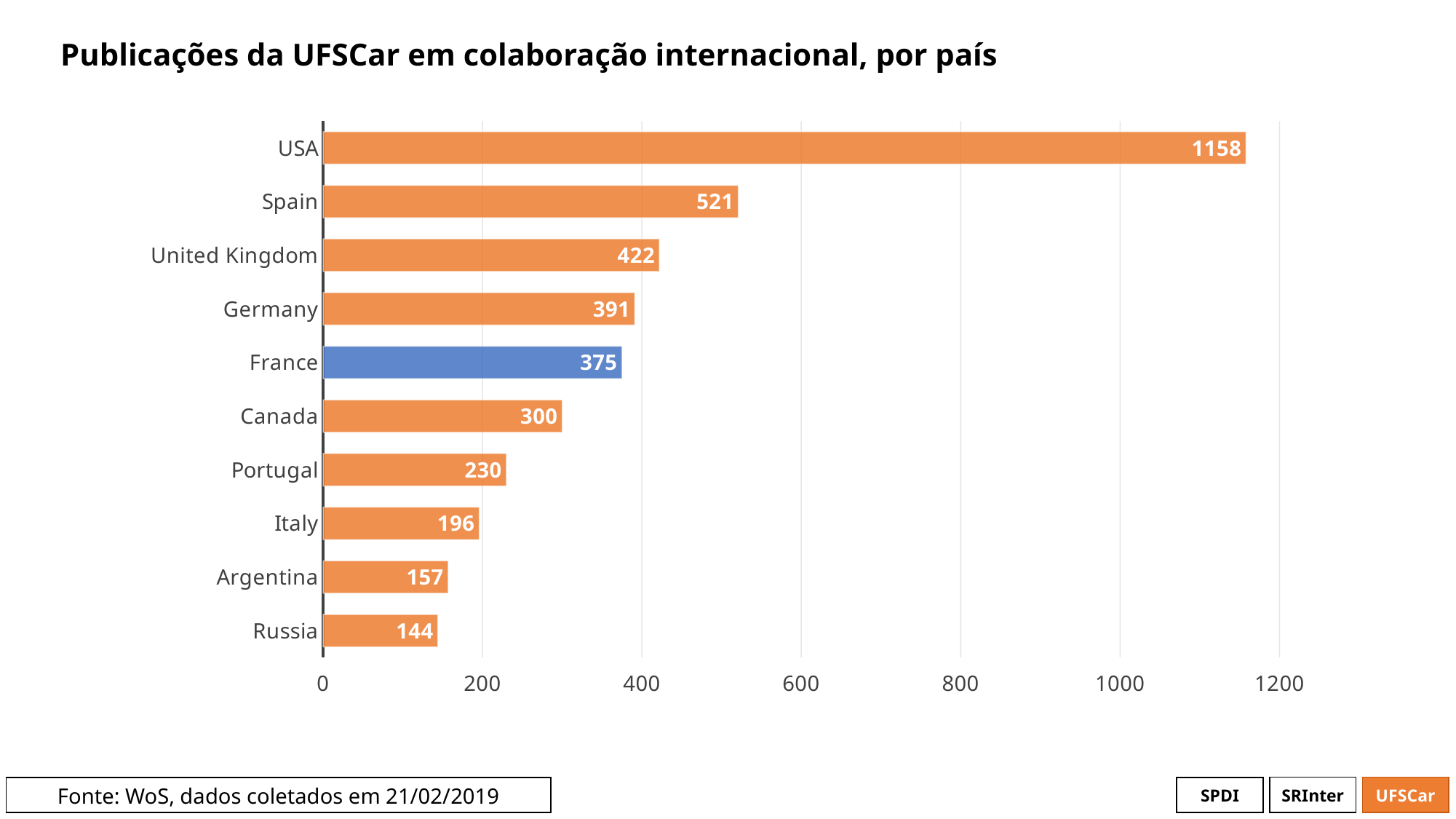
Which country has the highest value? USA Is the value for Argentina greater or less than 200? less What is the value for Portugal? 230 Which country has the lowest value? Russia What is the value for France? 375 What is the difference between the values for Canada and Italy? 104 What kind of chart is shown on the slide? bar chart How many countries are shown in the chart? 10 What is the value for USA? 1158 Which is larger, the value for Germany or the value for France? Germany Which country's bar is coloured blue instead of orange? France What is the difference between the values for Spain and United Kingdom? 99